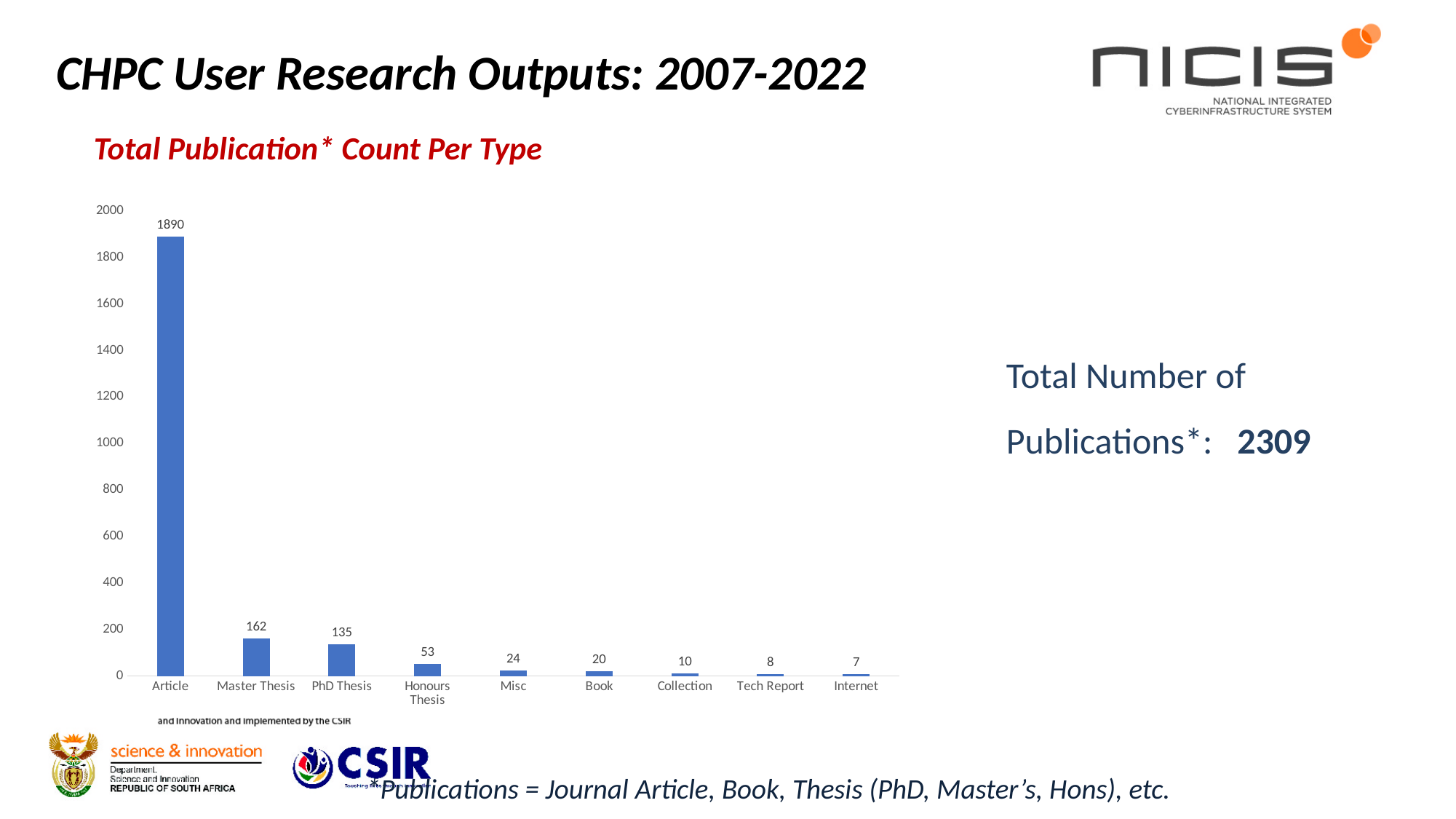
What kind of chart is shown on the slide? Bar chart What is the title of the chart? Total Publication* Count Per Type Which publication type has the highest count? Article What is the publication count for Tech Report? 8 What is the publication count for Article? 1890 Which has a larger count, Misc or Book? Misc Is the value for Article greater or less than 1800? greater How many publication types are shown on the x axis? 9 Which publication type has the lowest count? Internet What is the publication count for Master Thesis? 162 What is the difference between the counts for Master Thesis and PhD Thesis? 27 What is the publication count for Honours Thesis? 53